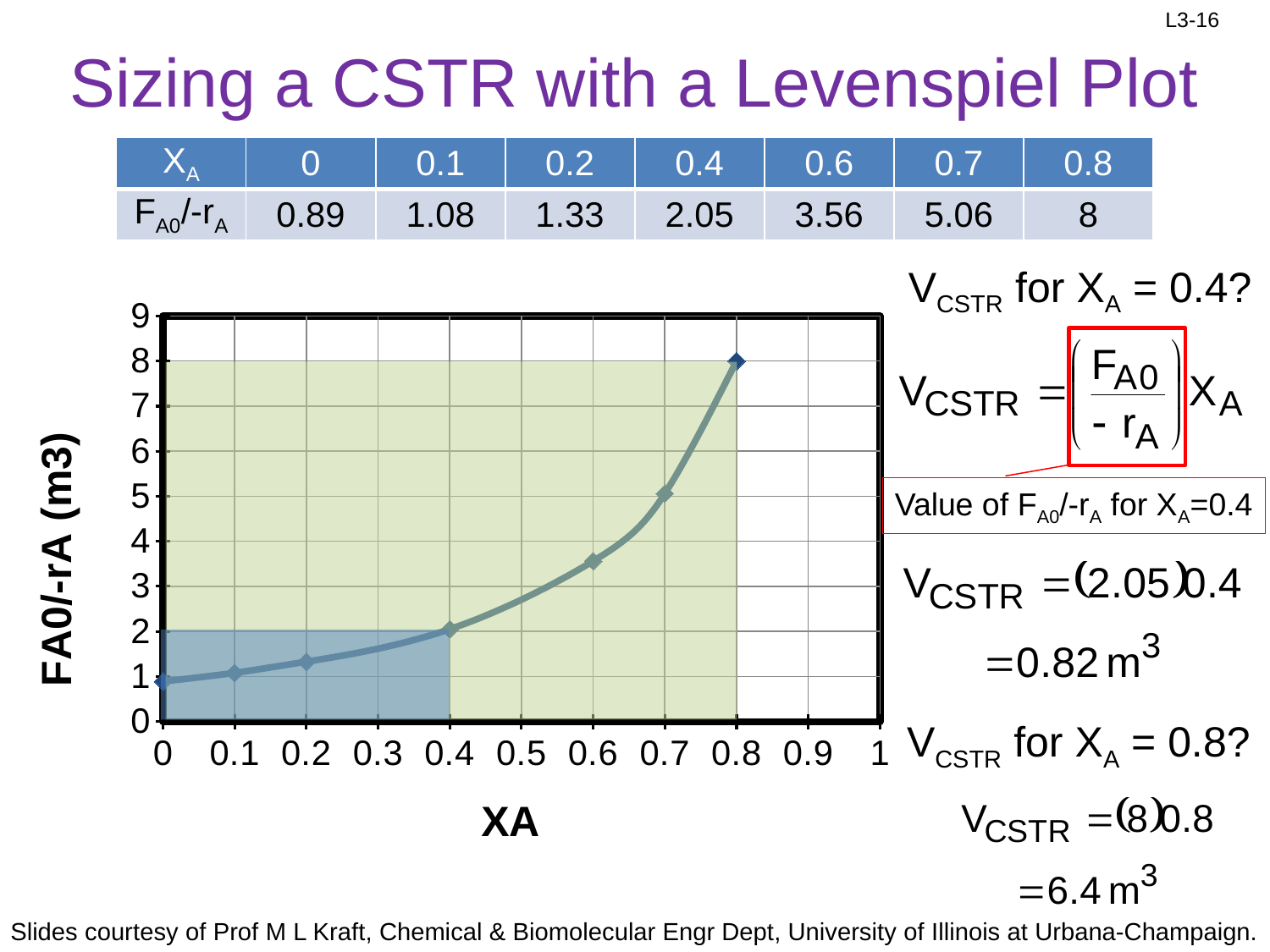
Which is larger, FA0/-rA at XA = 0.7 or at XA = 0.6? XA = 0.7 At which XA value is FA0/-rA highest? 0.8 Is the value of FA0/-rA at XA = 0.2 greater or less than 2? less What is the value of FA0/-rA at XA = 0.4? 2.05 What is the value of FA0/-rA at XA = 0.8? 8 Do the values of FA0/-rA rise or fall as XA increases? rise Is the value of FA0/-rA at XA = 0.6 greater or less than 3? greater At which XA value is FA0/-rA lowest? 0 What is the value of FA0/-rA at XA = 0? 0.89 What kind of chart is shown on the slide? line chart What is the label of the x axis of the chart? XA How many data points are plotted on the chart? 7